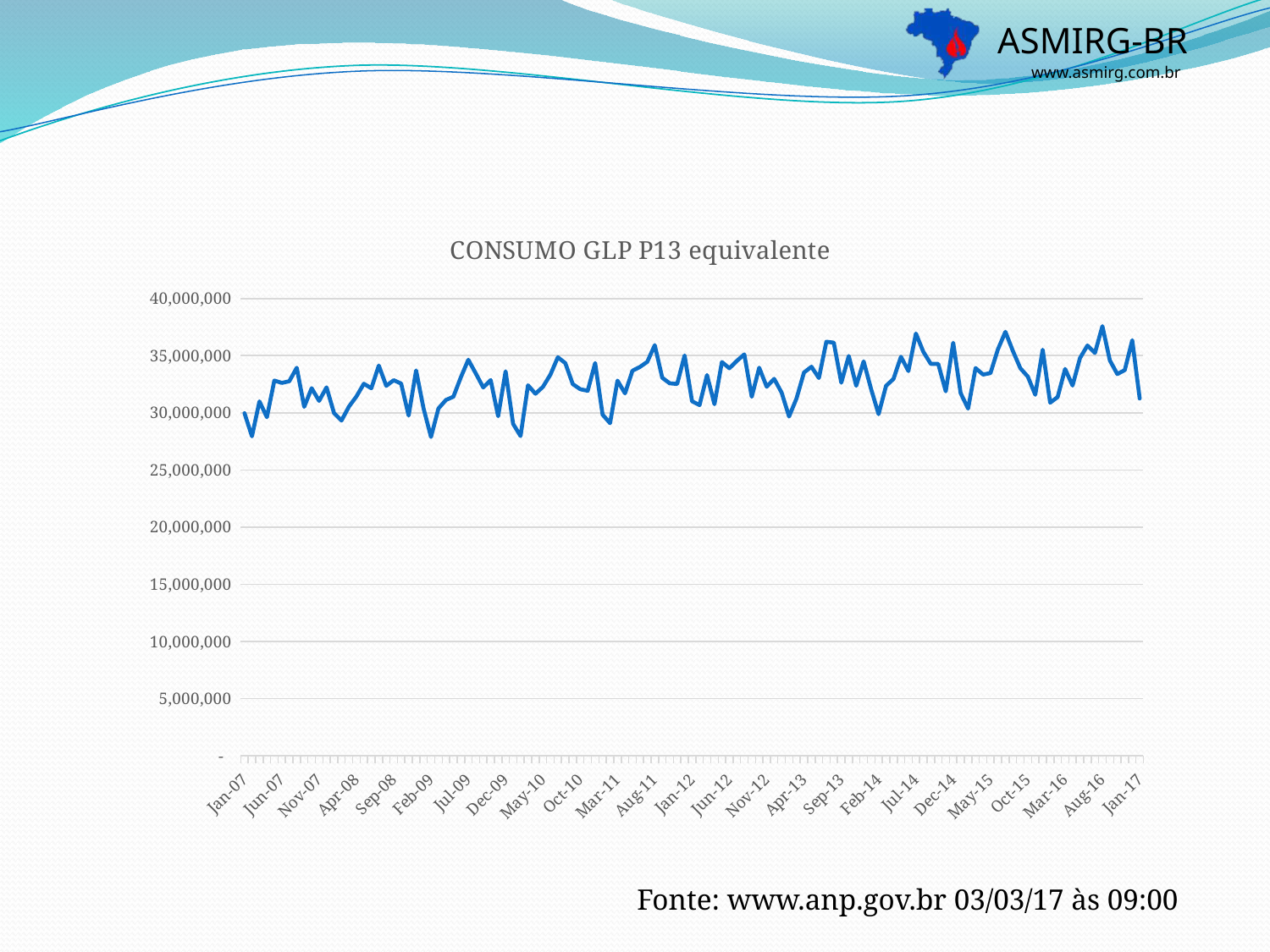
What kind of chart is shown on the slide? line chart Is the lowest point on the line greater or less than 30,000,000? less Is the highest point on the line greater or less than 35,000,000? greater Is the value for Jan-07 greater or less than 35,000,000? less What is the highest value shown on the y axis? 40,000,000 What is the title of the chart? CONSUMO GLP P13 equivalente What is the first month label on the x axis of the chart? Jan-07 Overall, do the values tend to rise or fall from Jan-07 to Jan-17? rise